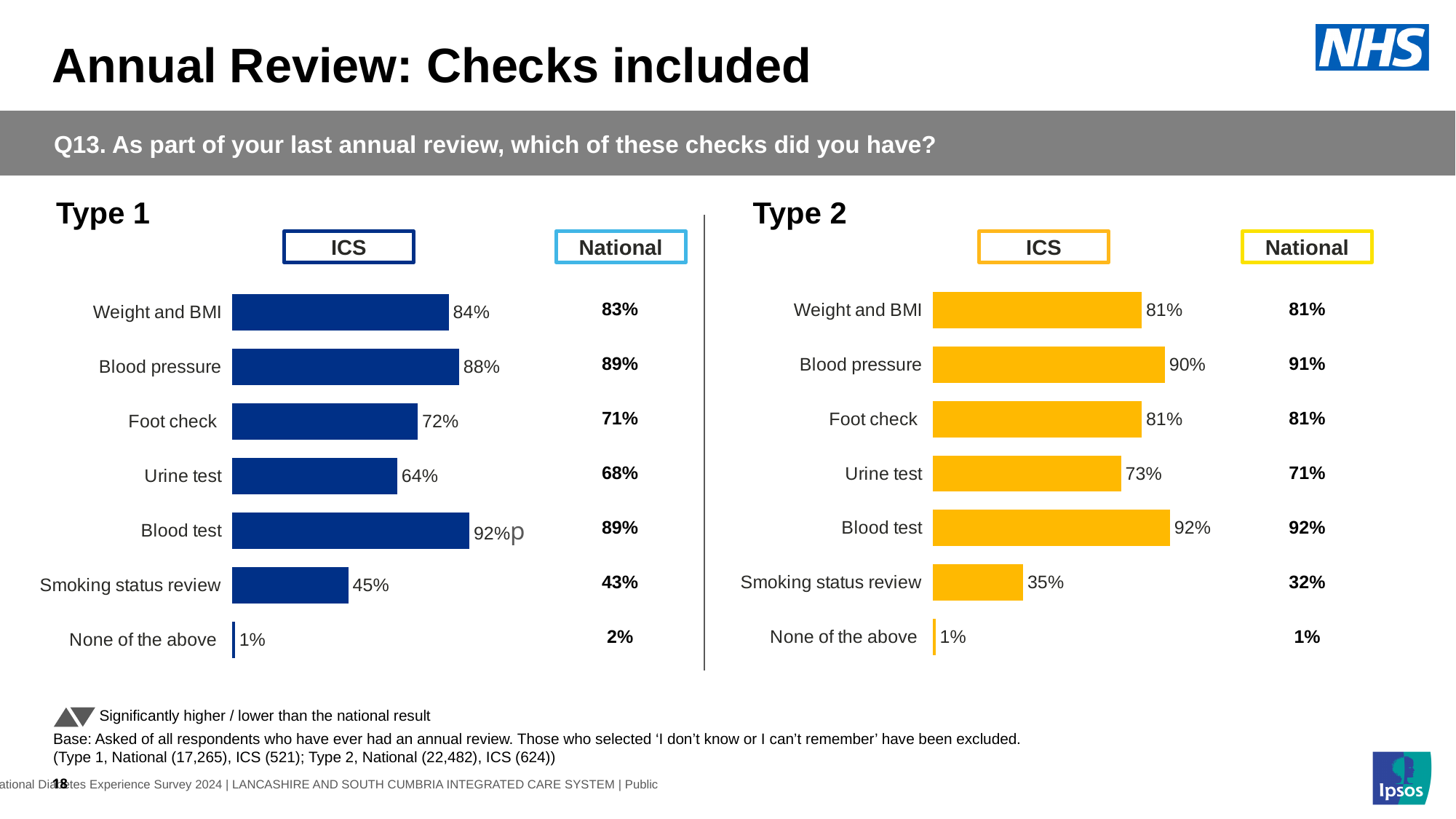
What colour are the ICS bars in the Type 2 chart? yellow In the Type 2 chart, what is the National value for Blood pressure? 91% How many checks are listed in the Type 2 chart? 7 In the Type 2 chart, what is the ICS value for Smoking status review? 35% In the Type 1 chart, is the ICS value for Smoking status review higher or lower than the National value? higher What type of chart is used for the Type 1 ICS results? bar chart In the Type 1 chart, what is the National value for Urine test? 68% In the Type 1 chart, what is the ICS value for Foot check? 72% In the Type 2 chart, which check has the lowest ICS value? None of the above In the Type 1 chart, which check has the highest ICS value? Blood test In the Type 1 chart, what is the difference between the ICS and National values for Blood test? 3 percentage points In the Type 2 chart, what is the difference between the ICS values for Blood pressure and Urine test? 17 percentage points